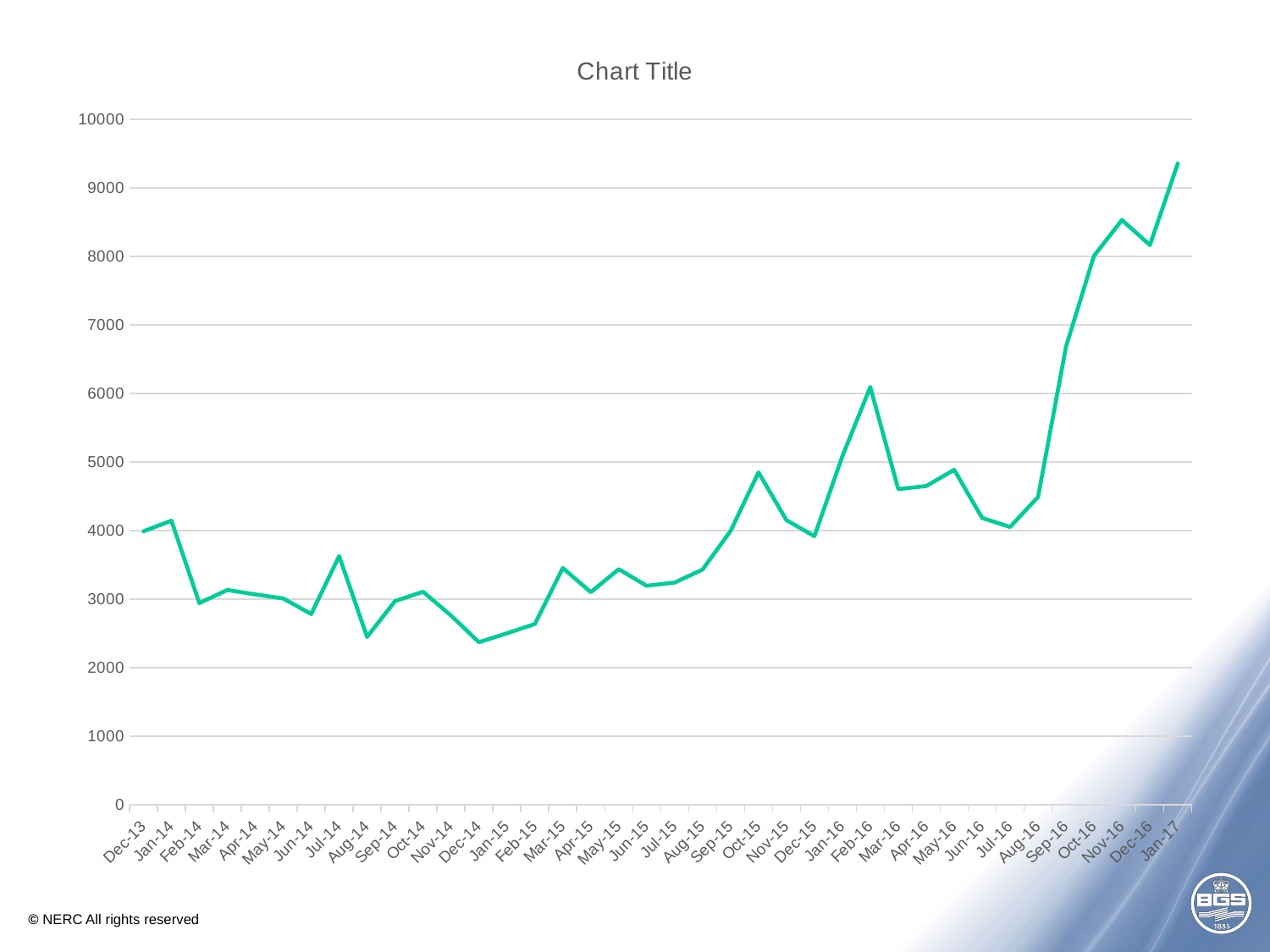
What kind of chart is shown on the slide? line chart Is the value for Nov-16 greater or less than 8000? greater Which month has the highest value on the chart? Jan-17 Is the value for Dec-14 greater or less than 3000? less Which is larger, the value for Feb-16 or the value for Oct-15? Feb-16 How many monthly data points are plotted on the x axis? 38 Is the value for Feb-16 greater or less than 5000? greater Overall, do the values rise or fall from Dec-13 to Jan-17? rise What is the title of the chart? Chart Title